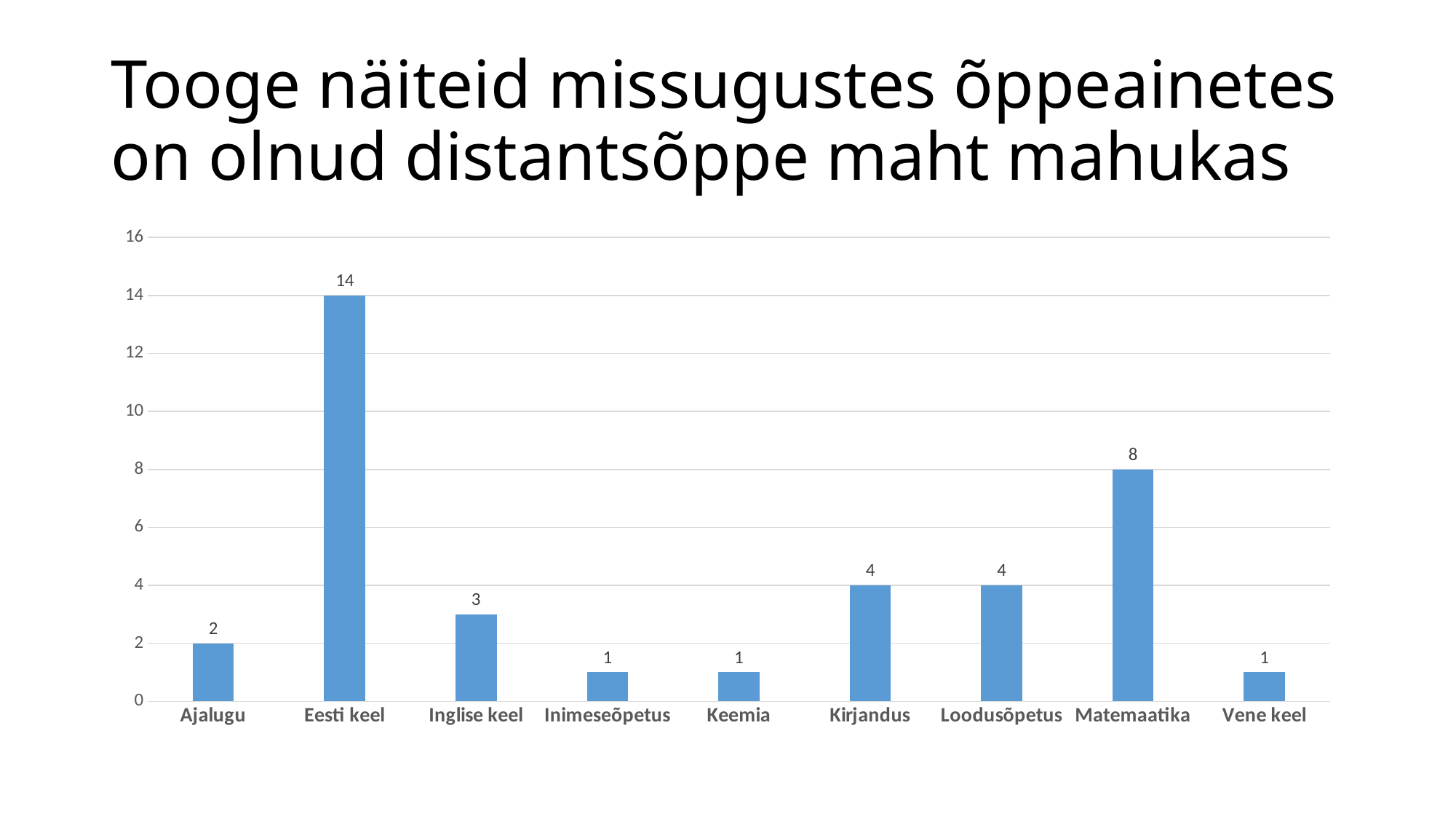
What is the value for Ajalugu? 2 What is the value for Inglise keel? 3 What is the value for Matemaatika? 8 Which category has the highest value? Eesti keel Is the value for Matemaatika greater or less than 10? less Which is larger, the value for Inglise keel or the value for Loodusõpetus? Loodusõpetus How many categories are shown on the x axis? 9 What is the difference between the values for Kirjandus and Ajalugu? 2 What kind of chart is shown on the slide? bar chart What is the title of the slide? Tooge näiteid missugustes õppeainetes on olnud distantsõppe maht mahukas What is the difference between the values for Eesti keel and Matemaatika? 6 What is the value for Eesti keel? 14